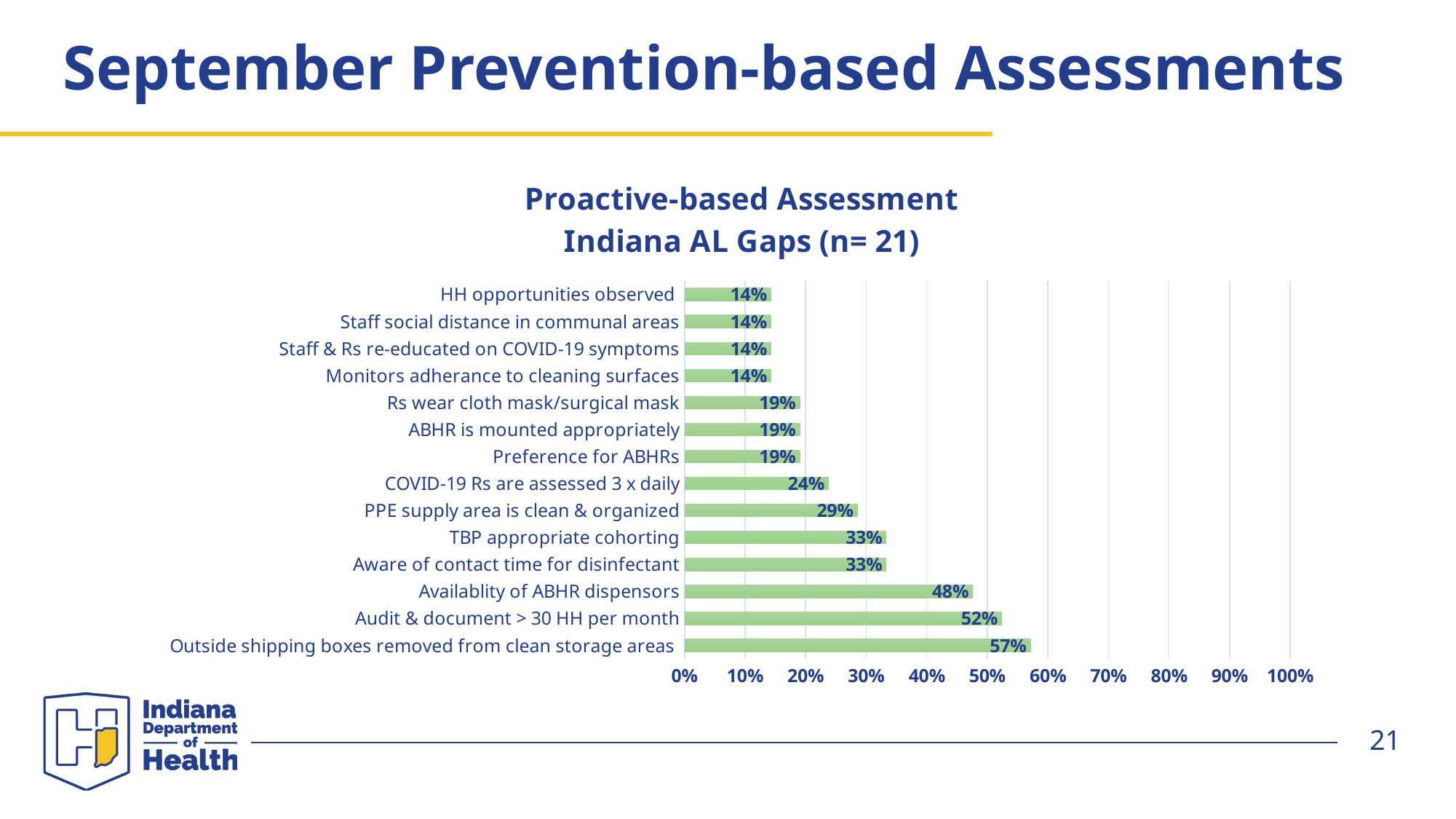
What kind of chart is shown on the slide? Bar chart What is the value for "Availablity of ABHR dispensors"? 48% Which is larger: "Availablity of ABHR dispensors" or "Aware of contact time for disinfectant"? Availablity of ABHR dispensors Which category has the highest value? Outside shipping boxes removed from clean storage areas What is the title of the chart? Proactive-based Assessment Indiana AL Gaps (n= 21) What is the highest value shown on the x axis? 100% What is the difference between "Audit & document > 30 HH per month" and "TBP appropriate cohorting"? 19% How many categories are shown in the chart? 14 What is the value for "PPE supply area is clean & organized"? 29% Is the value for "Audit & document > 30 HH per month" greater or less than 50%? greater What is the value for "COVID-19 Rs are assessed 3 x daily"? 24% What is the value for "Outside shipping boxes removed from clean storage areas"? 57%